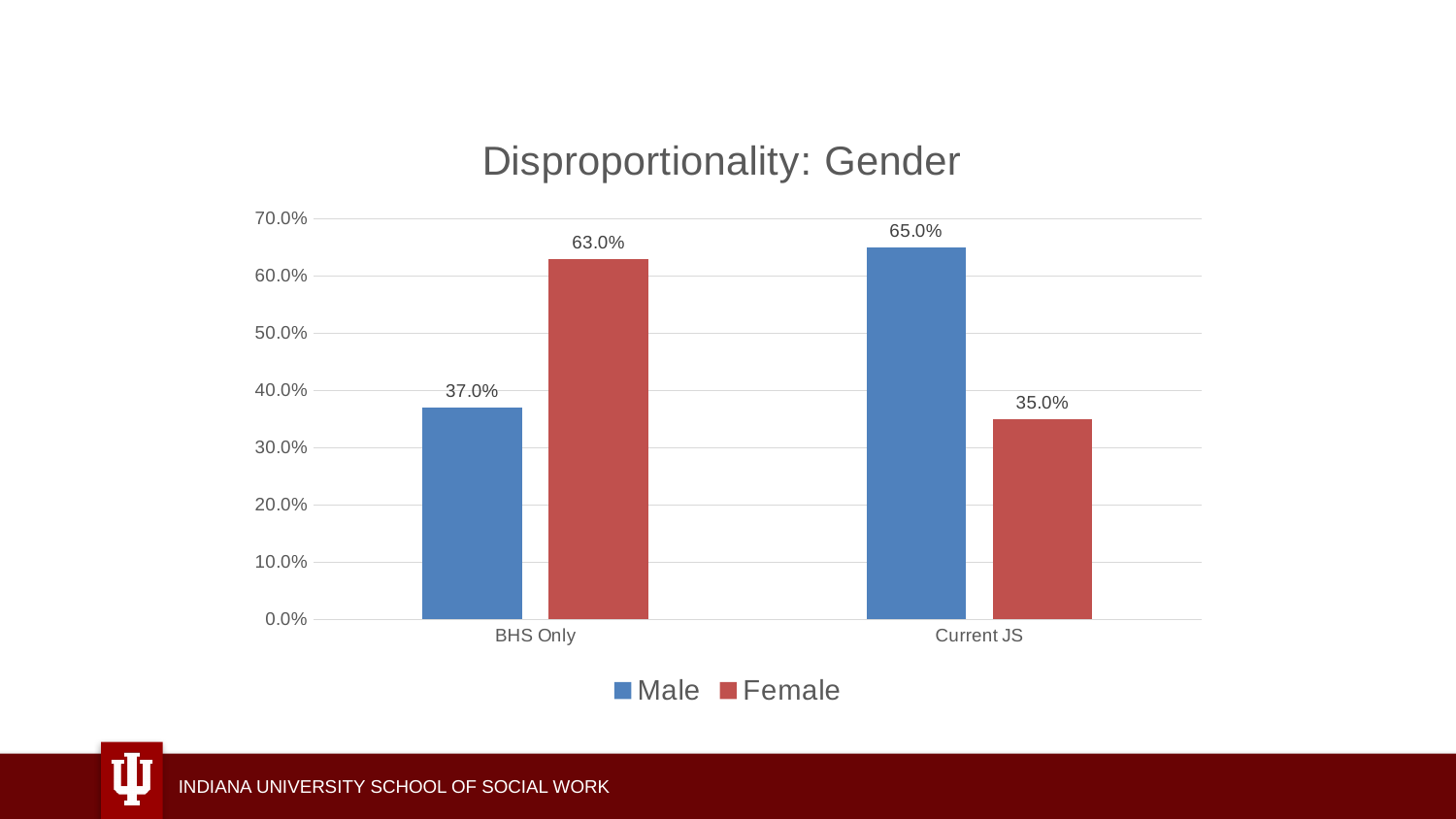
Is the Male value for Current JS greater or less than 60.0%? greater Which is larger for Current JS, the Male value or the Female value? Male What is the title of the chart? Disproportionality: Gender What is the Male value for BHS Only? 37.0% How many categories are shown on the x axis? 2 What is the difference between the Female and Male values for BHS Only? 26.0% How many series does the legend list? 2 Which category has the highest Male value? Current JS Which category has the lowest Female value? Current JS What is the Female value for Current JS? 35.0% What is the Female value for BHS Only? 63.0% What kind of chart is shown on the slide? bar chart